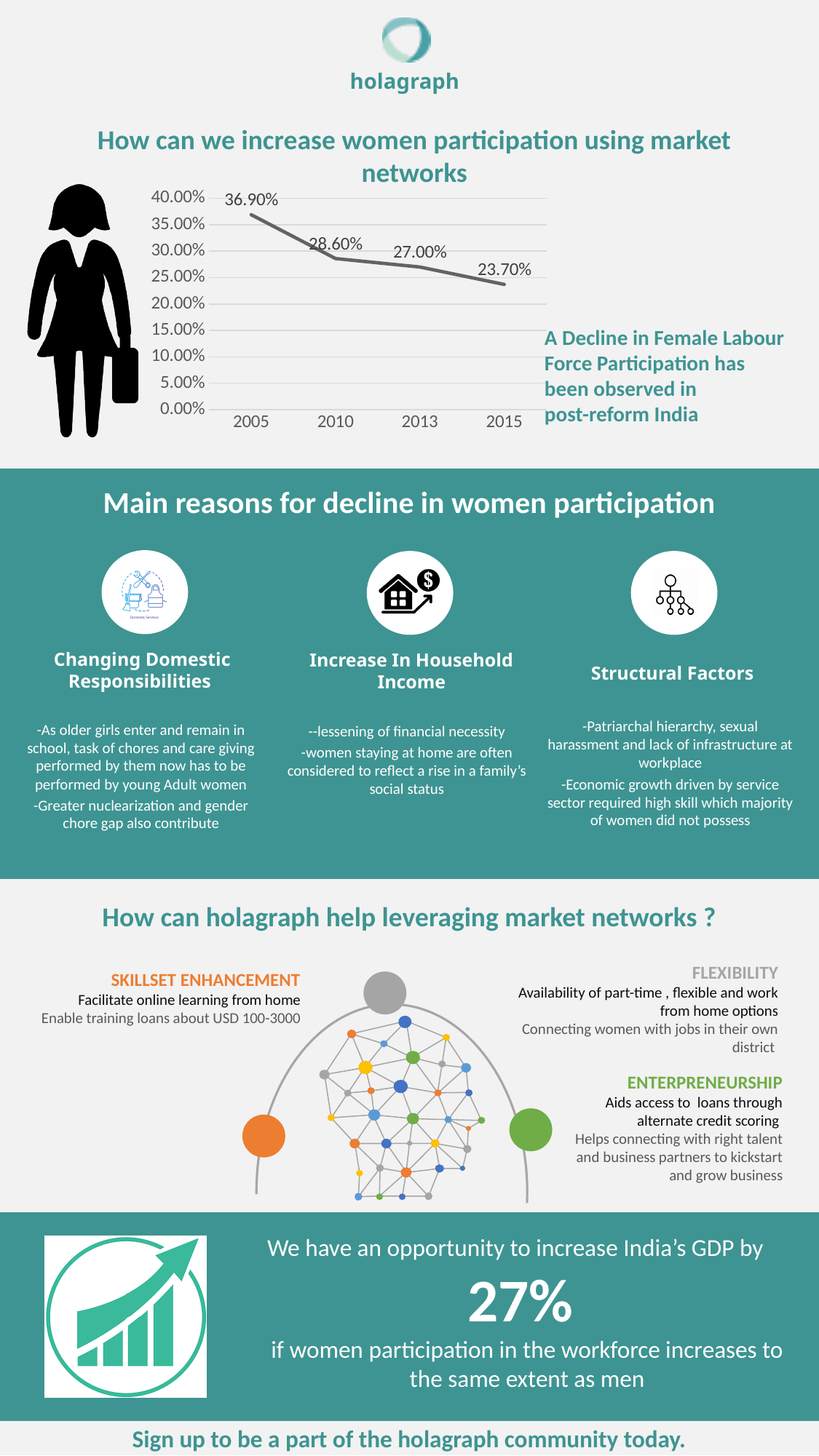
Is the value for 2015 in the line chart greater or less than 25.00%? less What is the value for 2005 in the line chart? 36.90% What is the difference between the 2005 value and the 2015 value in the line chart? 13.20% How many data points are plotted in the line chart? 4 Which is larger in the line chart, the value for 2010 or the value for 2013? 2010 Do the values in the line chart rise or fall from 2005 to 2015? fall What is the value for 2010 in the line chart? 28.60% Which year has the highest value in the line chart? 2005 What is the value for 2013 in the line chart? 27.00% Which year has the lowest value in the line chart? 2015 What kind of chart is shown at the top of the slide? line chart What is the value for 2015 in the line chart? 23.70%